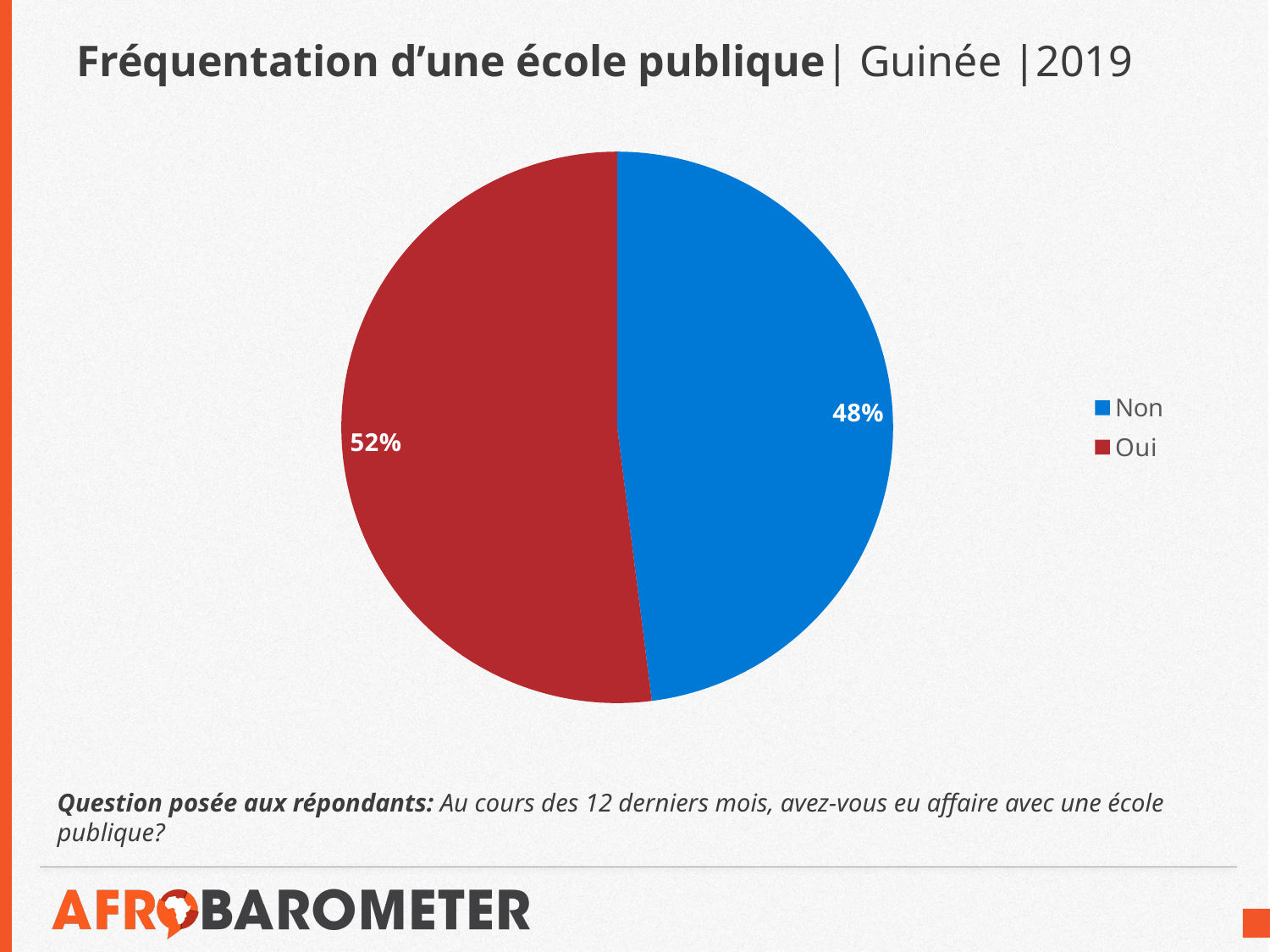
How many entries does the legend list? 2 What percentage of respondents answered "Oui"? 52% What share of the pie does the "Oui" slice represent? 52% How many slices does the pie chart have? 2 What kind of chart is shown on the slide? pie chart Which response has the larger share of the pie? Oui What is the difference in percentage points between "Oui" and "Non"? 4 percentage points Which colour represents "Non" in the chart? blue Which country and year does the chart title refer to? Guinée, 2019 Which response has the smaller share of the pie? Non What percentage of respondents answered "Non"? 48% Is the share for "Non" larger or smaller than the share for "Oui"? smaller